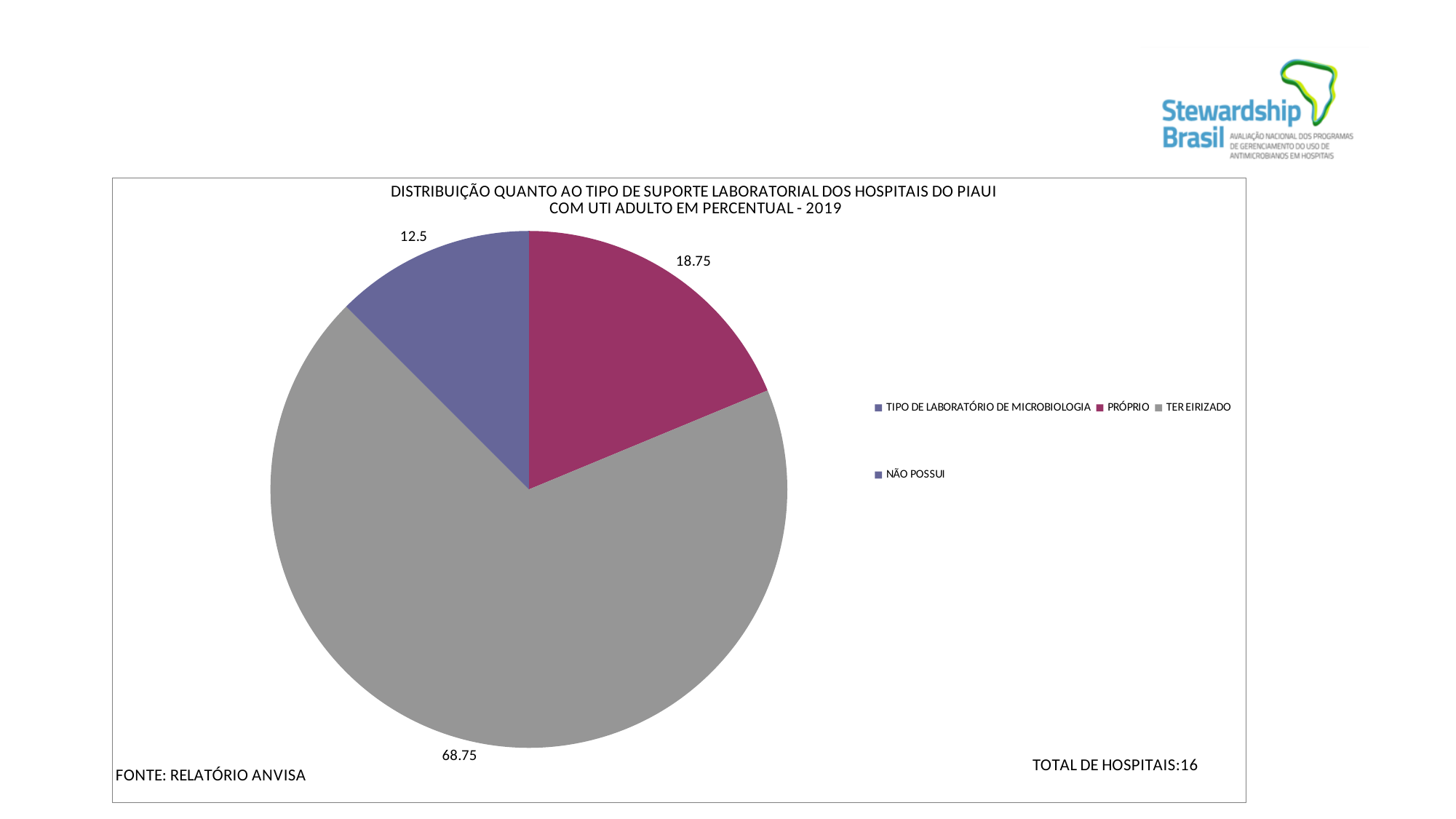
How many entries does the legend list? 4 Which category has the largest slice of the pie? TER EIRIZADO How many slices are visible in the pie chart? 3 What is the difference between the TERCEIRIZADO value and the PRÓPRIO value? 50 What is the value shown for the NÃO POSSUI slice? 12.5 What is the value shown for the PRÓPRIO slice? 18.75 What type of chart is shown on the slide? pie chart Which category has the smallest slice of the pie? NÃO POSSUI Which is larger, the PRÓPRIO slice or the NÃO POSSUI slice? PRÓPRIO What is the value shown for the gray TERCEIRIZADO slice? 68.75 What total number of hospitals is stated on the slide? 16 What is the difference between the PRÓPRIO value and the NÃO POSSUI value? 6.25